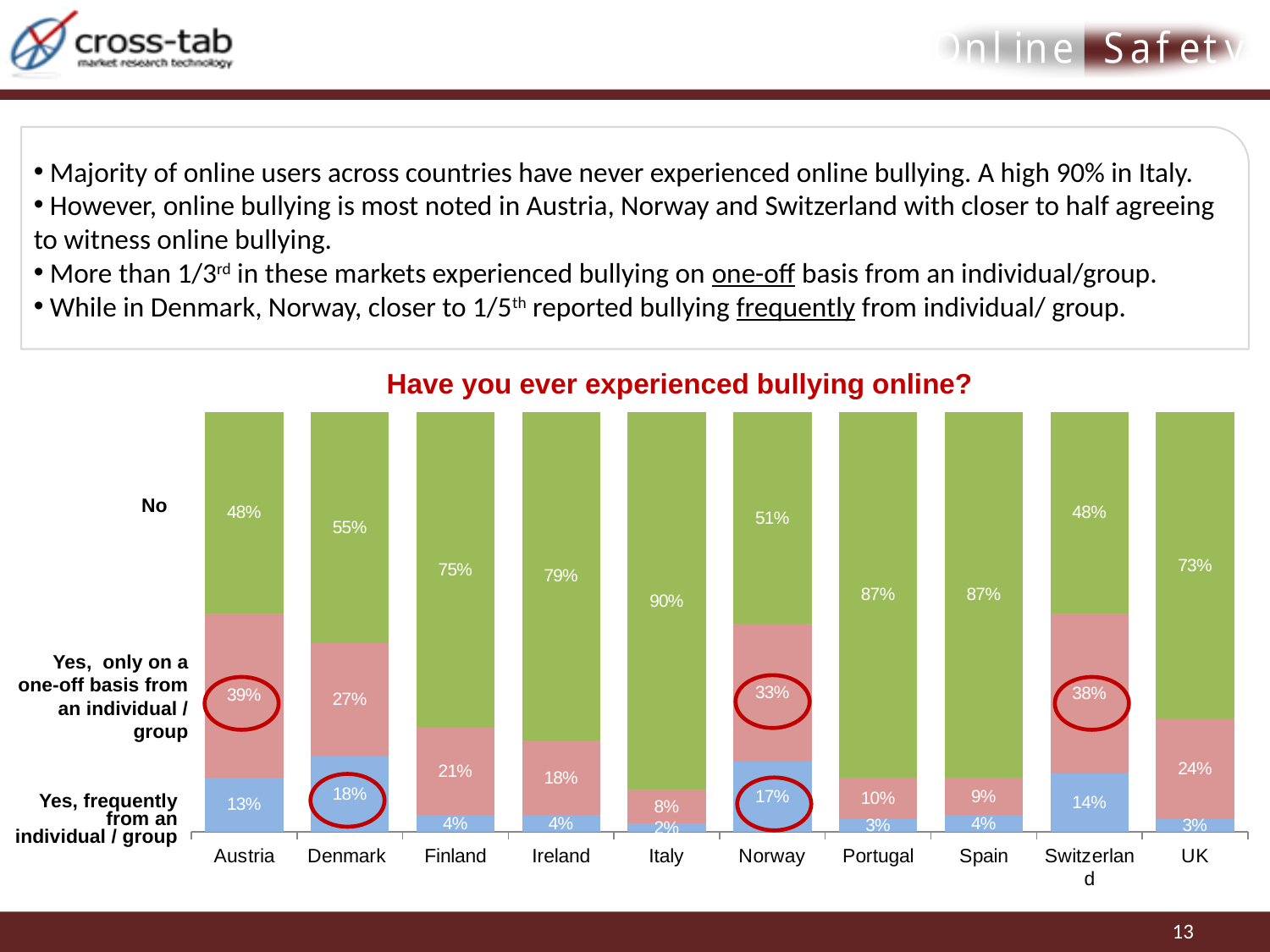
How many countries are shown on the x axis of the chart? 10 Which country has the highest share of respondents reporting bullying on a one-off basis from an individual/group? Austria What percentage of respondents in Norway said they experienced bullying frequently from an individual/group? 17% What percentage of respondents in the UK said they experienced bullying only on a one-off basis from an individual/group? 24% Which country has the highest share of respondents answering "No"? Italy Which country has a larger share of respondents answering "No": Finland or Ireland? Ireland What is the total of the three segments in the Austria bar? 100% What is the title of the chart on the slide? Have you ever experienced bullying online? Which country has the lowest share of respondents reporting bullying frequently from an individual/group? Italy What type of chart is used to show the responses to "Have you ever experienced bullying online?"? Stacked bar chart What percentage of respondents in Italy answered "No" to having experienced bullying online? 90% What is the difference in percentage points between Austria's and Denmark's shares for bullying on a one-off basis from an individual/group? 12 percentage points